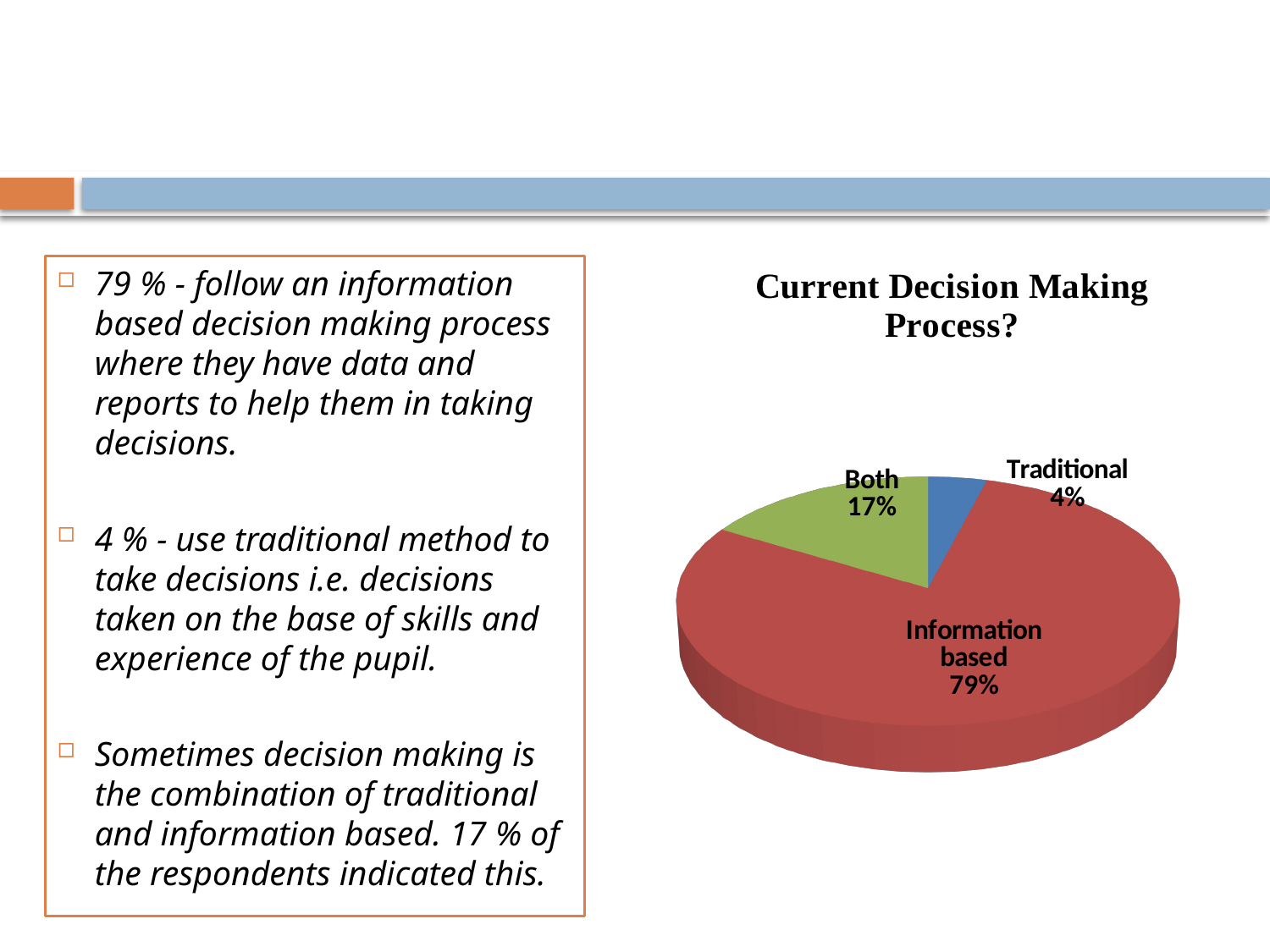
What is the title of the chart? Current Decision Making Process? What is the difference in percentage points between the Information based slice and the Both slice? 62 What share of the pie is labelled Both? 17% Which is larger, the Both slice or the Traditional slice? Both What kind of chart is shown on the slide? pie chart Which slice of the pie is the smallest? Traditional What share of the pie is labelled Traditional? 4% What share of the pie is labelled Information based? 79% What is the difference in percentage points between the Both slice and the Traditional slice? 13 How many slices does the pie chart have? 3 Which slice of the pie is the largest? Information based What colour is the Information based slice? red